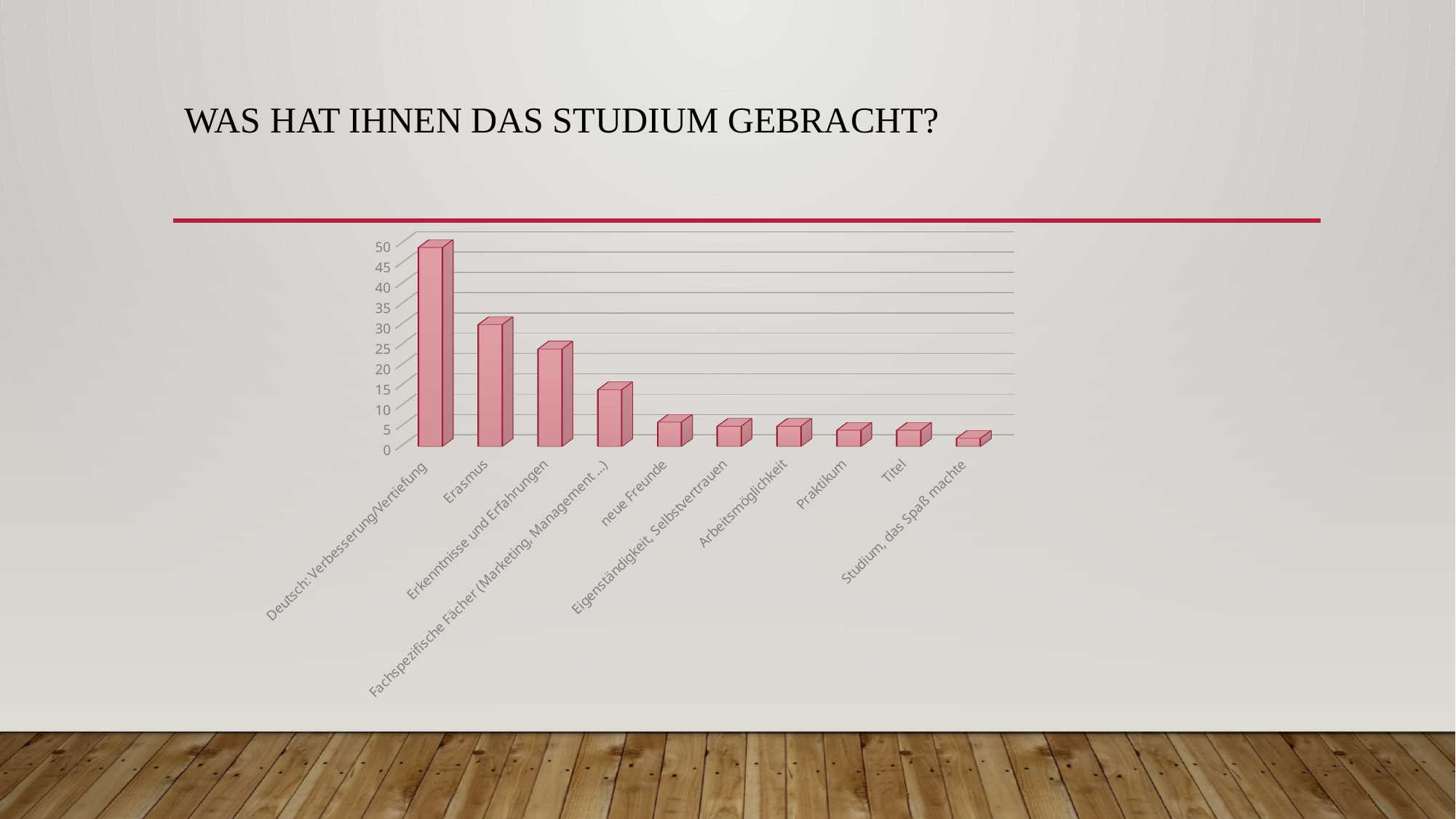
Which category has the lowest value in the chart? Studium, das Spaß machte Is the value for Erkenntnisse und Erfahrungen greater or less than 30? less What kind of chart is shown on the slide? bar chart Which category has the highest value in the chart? Deutsch: Verbesserung/Vertiefung Which is larger, the value for Erasmus or the value for Erkenntnisse und Erfahrungen? Erasmus Is the value for Deutsch: Verbesserung/Vertiefung greater or less than 40? greater What is the title of the slide containing the chart? Was hat Ihnen das Studium gebracht? Is the value for Erasmus greater or less than 20? greater Do the values rise or fall from left to right along the x axis? fall How many categories are plotted in the chart? 10